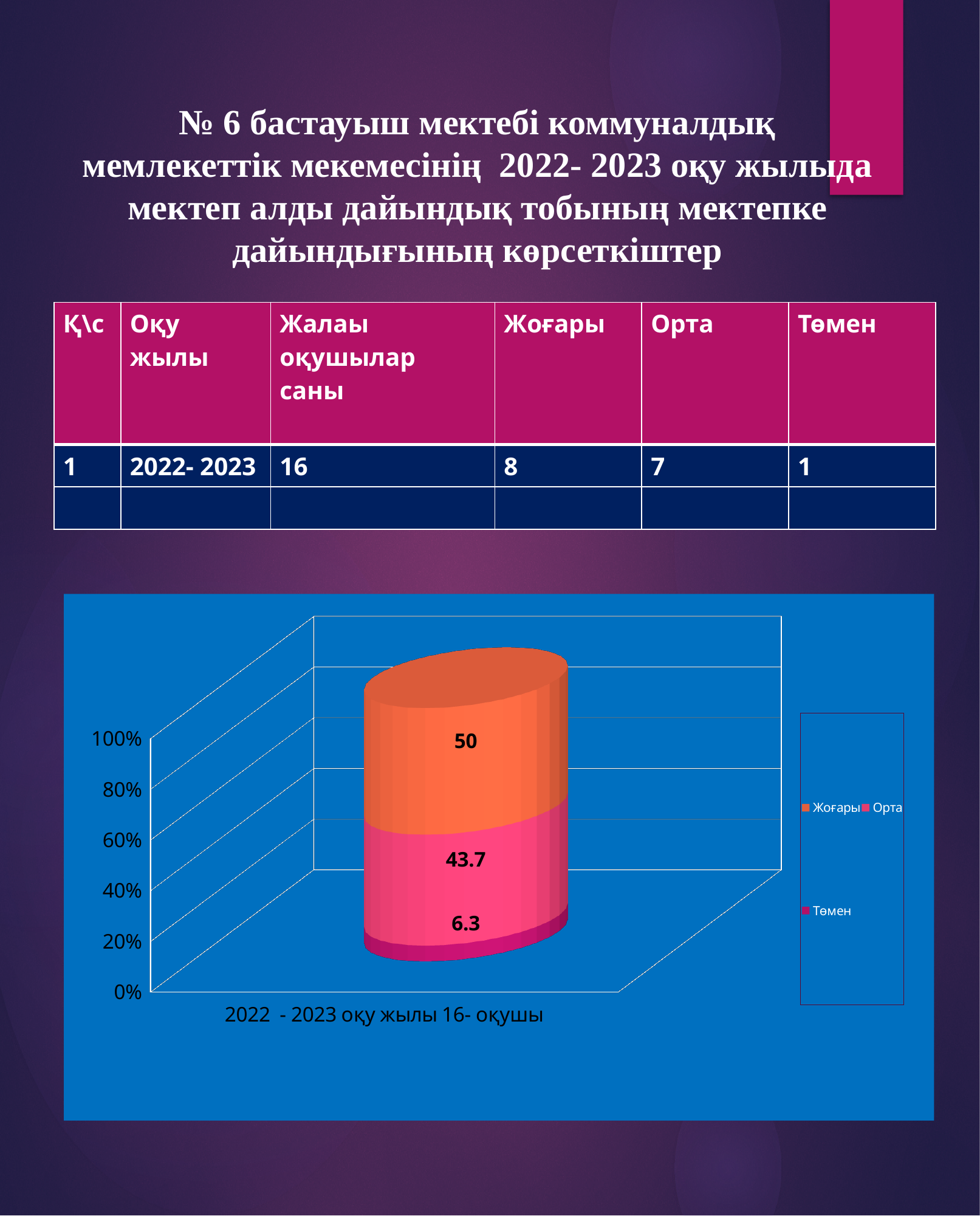
What is the value shown for the Жоғары series in the chart? 50 What is the value shown for the Орта series in the chart? 43.7 What is the total of the stacked bar in the chart? 100 What kind of chart is shown on the slide? Stacked bar chart Which series has the largest value in the chart? Жоғары What is the difference between the Жоғары value and the Орта value in the chart? 6.3 How many categories are plotted on the x axis of the chart? 1 What is the difference between the Орта value and the Төмен value in the chart? 37.4 Which series has the smallest value in the chart? Төмен Which is larger in the chart, the Орта value or the Төмен value? Орта How many series does the chart legend list? 3 What is the value shown for the Төмен series in the chart? 6.3